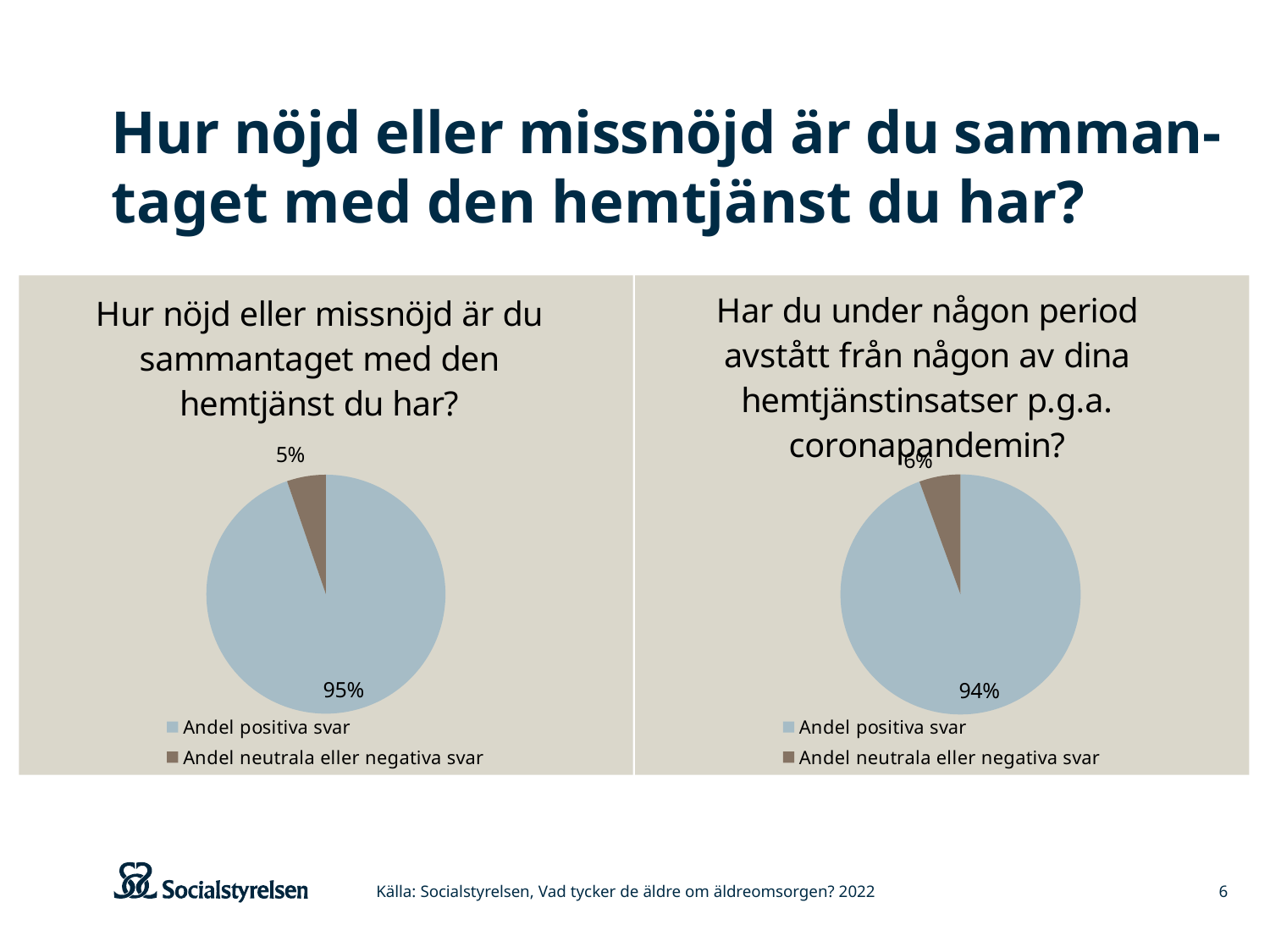
How many slices does the right chart have? 2 In the left chart, what share of responses is 'Andel positiva svar'? 95% In the left chart, what is the difference between the 'Andel positiva svar' and 'Andel neutrala eller negativa svar' shares? 90 percentage points What is the title of the right chart? Har du under någon period avstått från någon av dina hemtjänstinsatser p.g.a. coronapandemin? Which chart has the larger 'Andel positiva svar' share, the left chart or the right chart? The left chart In the right chart, what share of responses is 'Andel positiva svar'? 94% What kind of chart is the left chart? Pie chart In the left chart, which category has the largest slice? Andel positiva svar In the right chart, what share of responses is 'Andel neutrala eller negativa svar'? 6% In the left chart, what share of responses is 'Andel neutrala eller negativa svar'? 5% How many entries does the legend of the left chart list? 2 In the right chart, which category has the smallest slice? Andel neutrala eller negativa svar